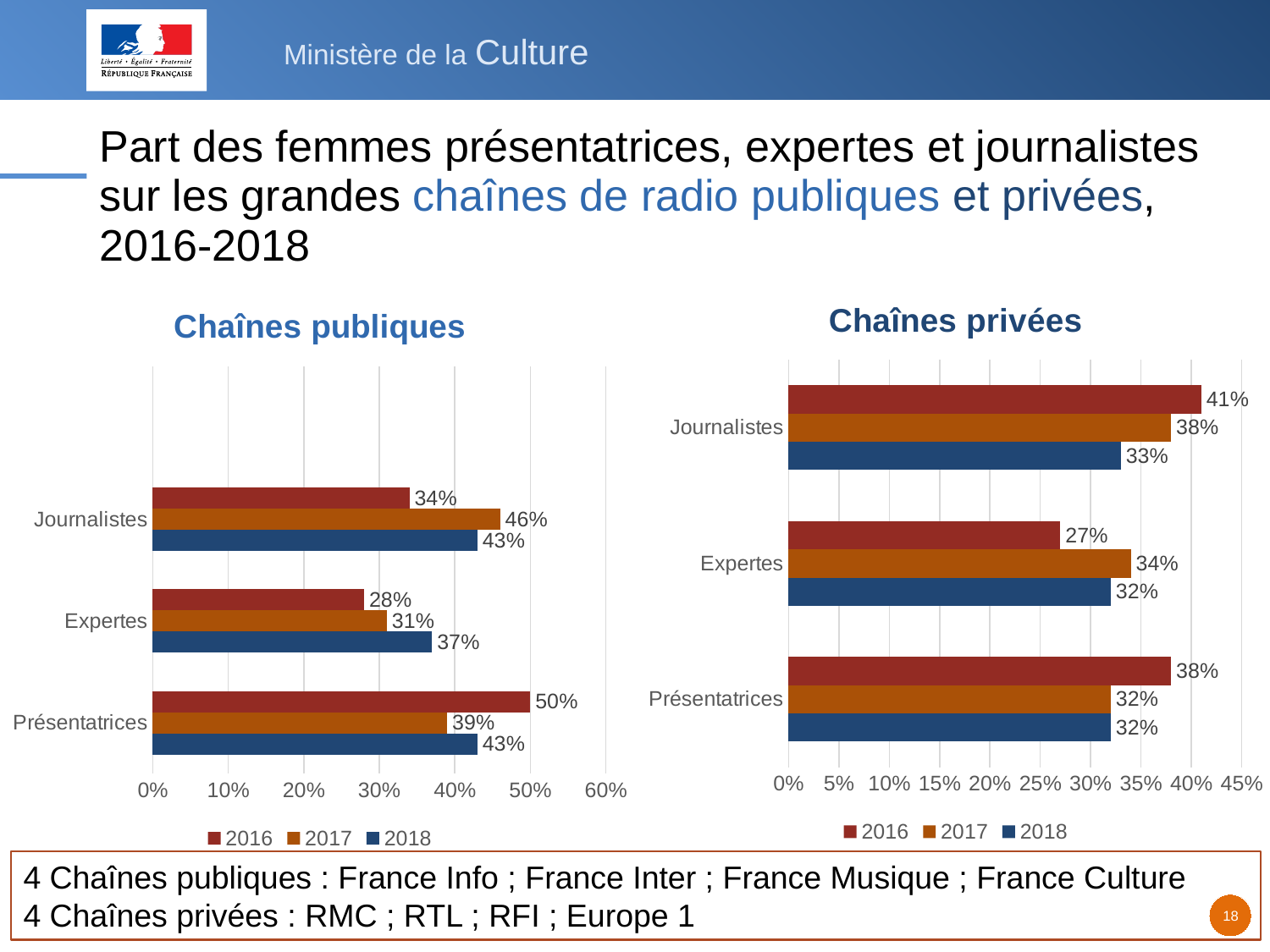
In the 'Chaînes privées' chart, what is the value for Expertes in 2017? 34% What type of chart is the 'Chaînes privées' chart? bar chart In the 'Chaînes privées' chart, do the values for Journalistes rise or fall from 2016 to 2018? fall In the 'Chaînes privées' chart, what is the difference between the 2016 and 2018 values for Journalistes? 8% In the 'Chaînes publiques' chart, what is the value for Présentatrices in 2016? 50% In the 'Chaînes privées' chart, what is the value for Journalistes in 2016? 41% In the 'Chaînes publiques' chart, what is the value for Expertes in 2018? 37% In the 'Chaînes publiques' chart, which is larger for Expertes: the 2016 value or the 2018 value? 2018 How many series does the legend of the 'Chaînes publiques' chart list? 3 In the 'Chaînes privées' chart, which category has the lowest value for 2016? Expertes In the 'Chaînes publiques' chart, what is the difference between the 2017 and 2016 values for Journalistes? 12% In the 'Chaînes publiques' chart, which category has the highest value for 2017? Journalistes